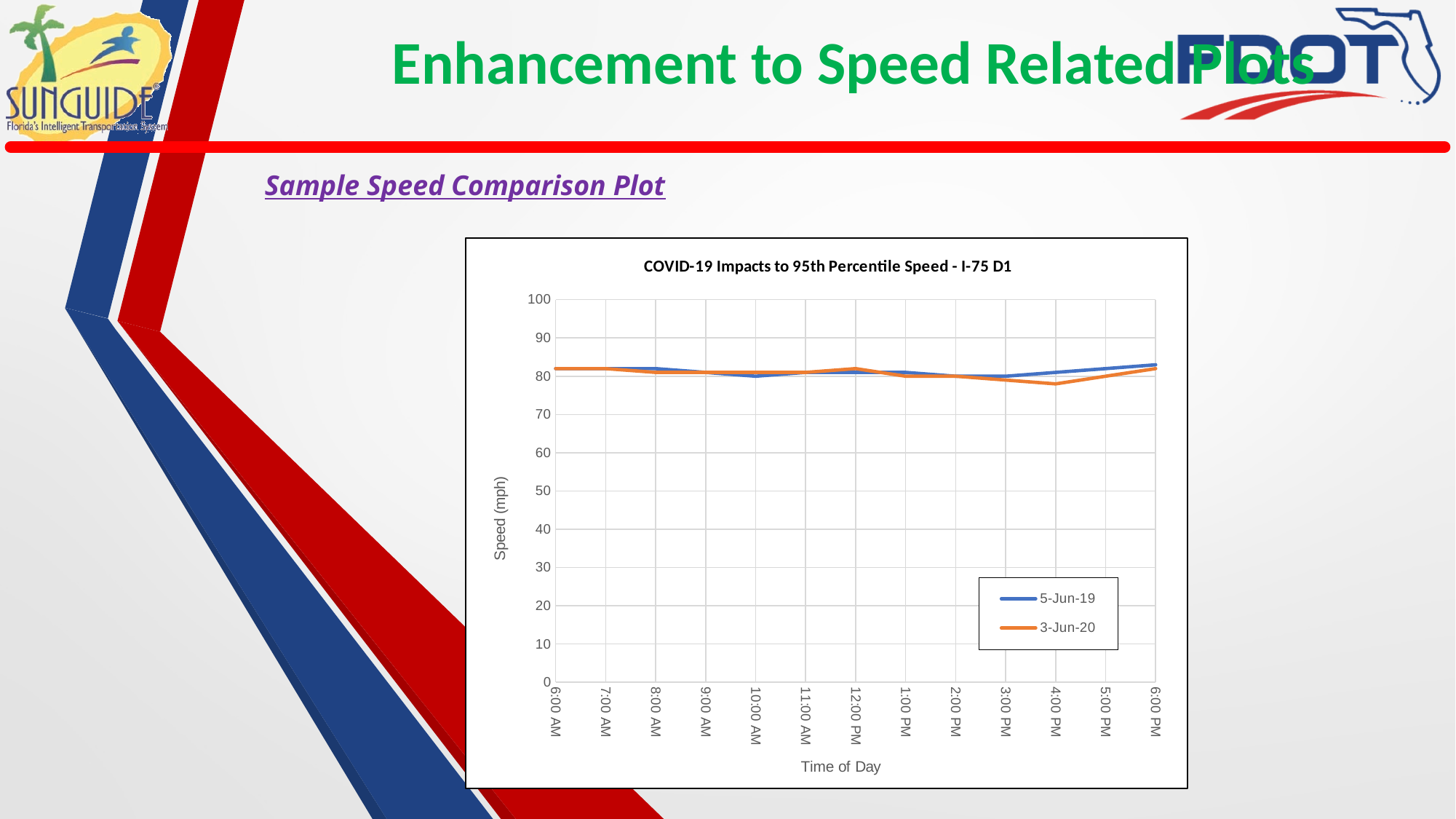
At what time of day does the 3-Jun-20 series reach its lowest speed? 4:00 PM Does the 3-Jun-20 series rise or fall between 4:00 PM and 6:00 PM? rise Is the 3-Jun-20 value at 4:00 PM greater or less than 70? greater How many series does the legend list? 2 Is the 5-Jun-19 value at 6:00 PM greater or less than 90? less Which series is drawn in orange? 3-Jun-20 Is the 5-Jun-19 value at 10:00 AM greater or less than 70? greater At what time of day does the 5-Jun-19 series reach its highest speed? 6:00 PM How many time-of-day points are plotted along the x axis? 13 What kind of chart is shown on the slide? Line chart What is the title of the chart? COVID-19 Impacts to 95th Percentile Speed - I-75 D1 At 4:00 PM, which series has the higher speed, 5-Jun-19 or 3-Jun-20? 5-Jun-19